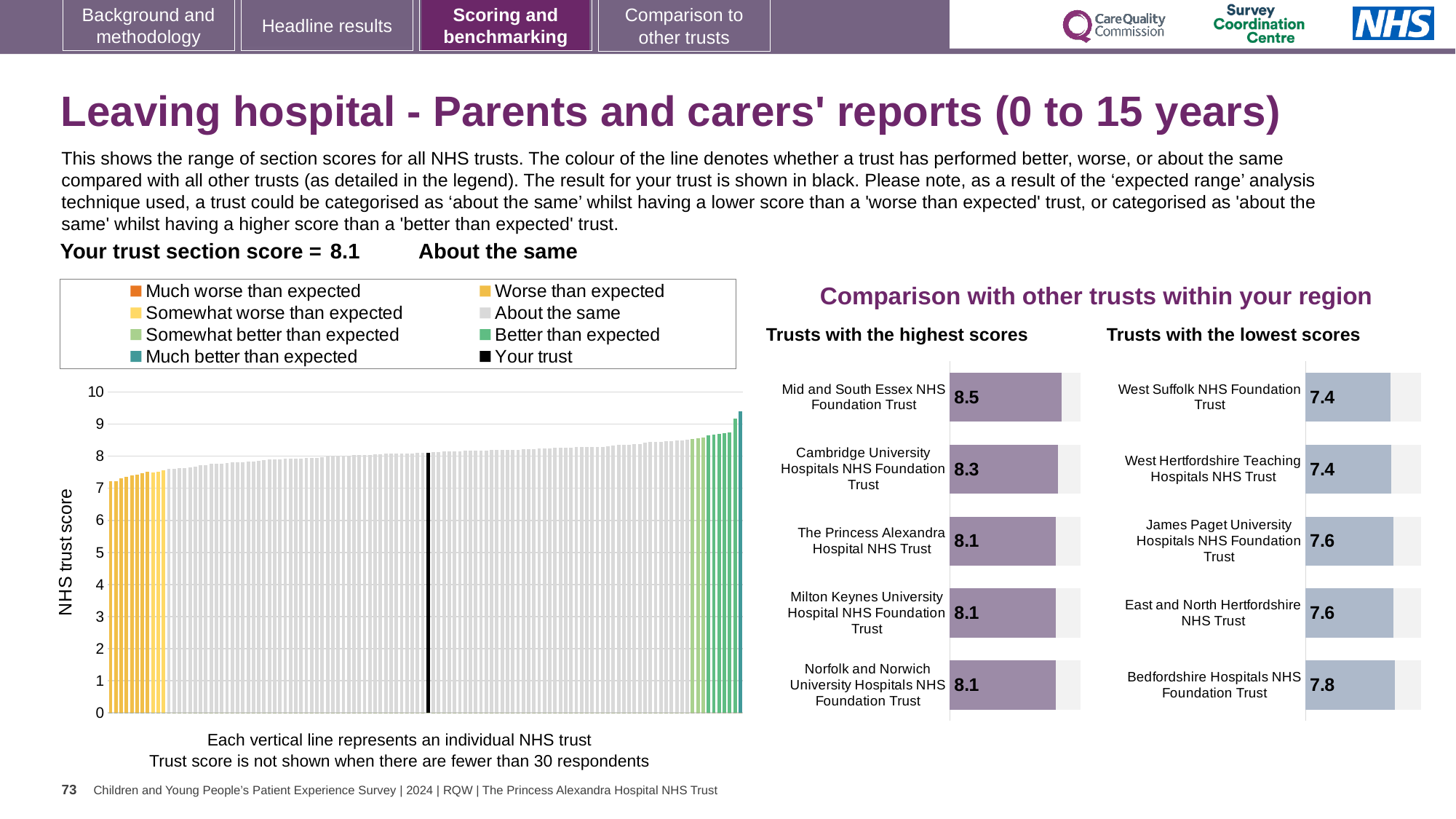
In the 'Trusts with the highest scores' chart, which trust has the highest score? Mid and South Essex NHS Foundation Trust How many trusts are shown in the 'Trusts with the lowest scores' chart? 5 In the 'Trusts with the lowest scores' chart, which trust has the highest score? Bedfordshire Hospitals NHS Foundation Trust In the 'Trusts with the lowest scores' chart, what is the difference between the scores of Bedfordshire Hospitals NHS Foundation Trust and West Suffolk NHS Foundation Trust? 0.4 In the 'Trusts with the lowest scores' chart, what is the score for Bedfordshire Hospitals NHS Foundation Trust? 7.8 In the 'Trusts with the highest scores' chart, what is the difference between the scores of Mid and South Essex NHS Foundation Trust and Cambridge University Hospitals NHS Foundation Trust? 0.2 Which has a higher score: Mid and South Essex NHS Foundation Trust in the 'highest scores' chart or Bedfordshire Hospitals NHS Foundation Trust in the 'lowest scores' chart? Mid and South Essex NHS Foundation Trust In the 'Trusts with the highest scores' chart, what is the score for Cambridge University Hospitals NHS Foundation Trust? 8.3 How many entries does the legend of the large chart on the left list? 8 In the 'Trusts with the highest scores' chart, what is the score for Mid and South Essex NHS Foundation Trust? 8.5 In the 'Trusts with the lowest scores' chart, what is the score for West Suffolk NHS Foundation Trust? 7.4 In the large chart on the left, do the trust scores rise or fall from left to right? rise